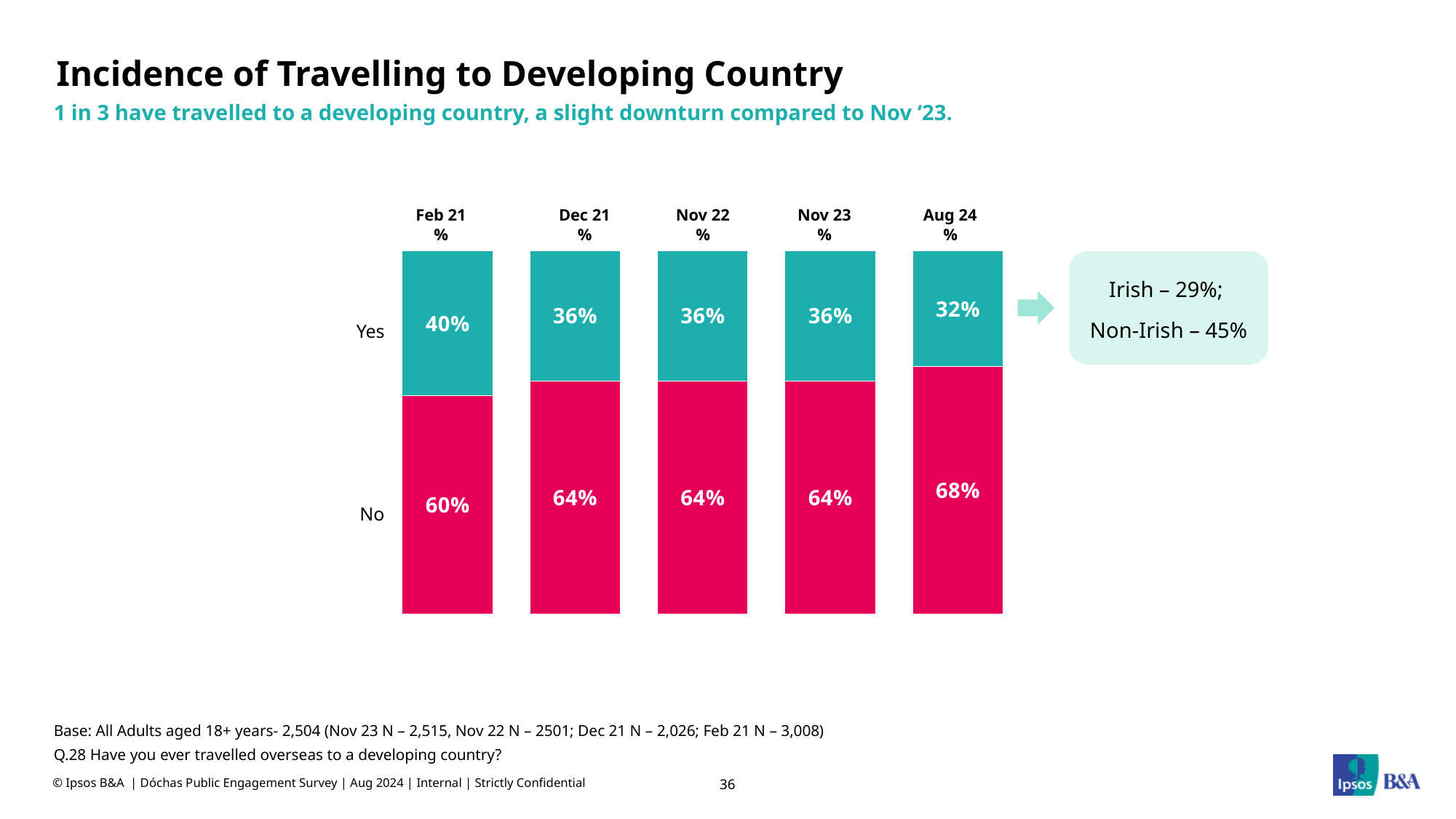
What percentage answered No in Feb 21? 60% What kind of chart is shown on the slide? Stacked bar chart In which wave was the Yes share highest? Feb 21 How many response categories (series) are stacked in each bar? 2 Does the Yes share rise or fall from Feb 21 to Aug 24? Fall Which is larger: the No share in Aug 24 or the No share in Nov 23? No share in Aug 24 What is the difference between the Yes share in Feb 21 and the Yes share in Aug 24? 8 percentage points In which wave was the Yes share lowest? Aug 24 What percentage answered Yes in Nov 23? 36% What is the total of the Yes and No segments for the Dec 21 bar? 100% How many survey waves are shown on the chart? 5 What percentage answered Yes in Aug 24? 32%